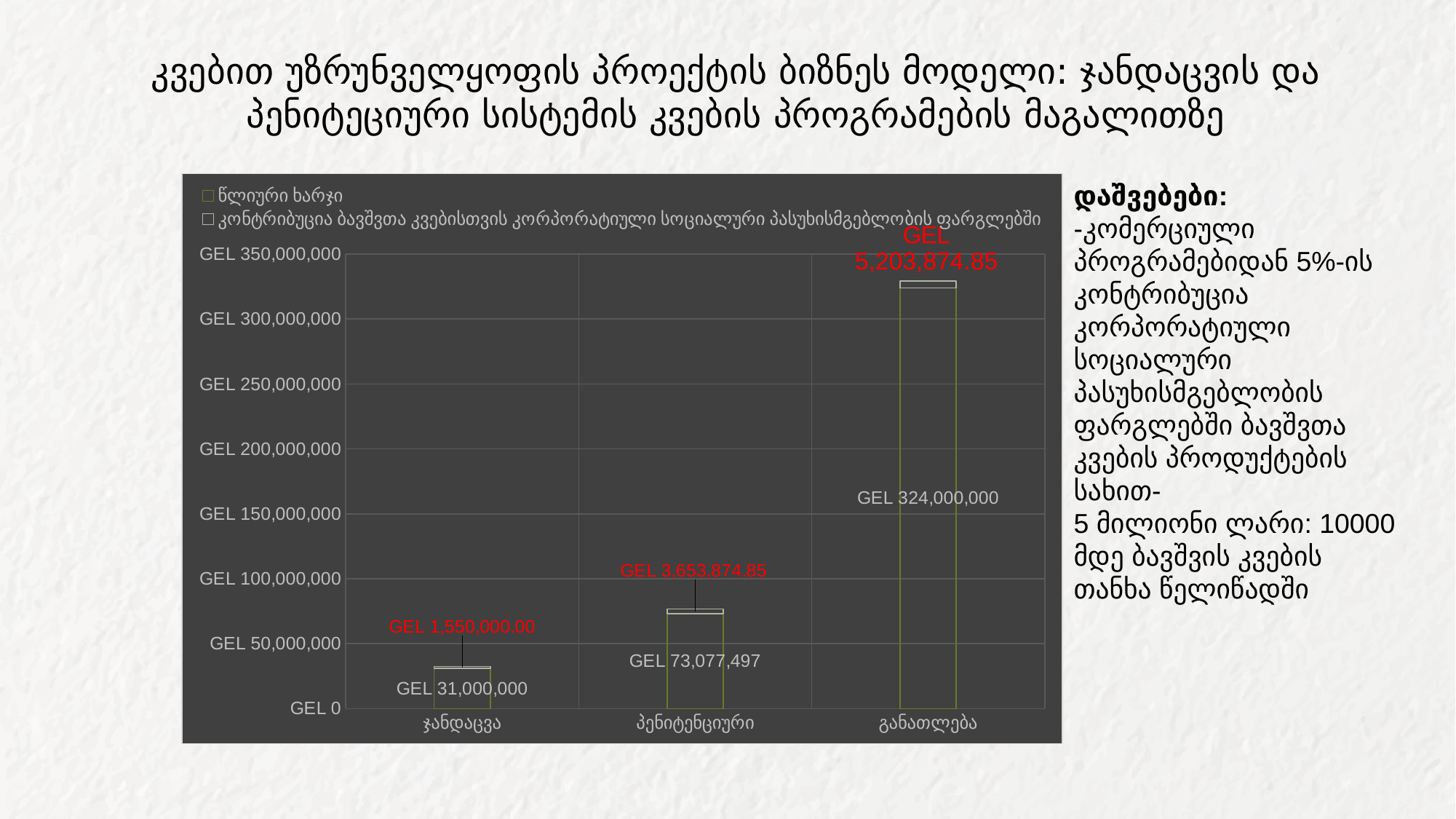
Which category has the highest წლიური ხარჯი value? განათლება What is the წლიური ხარჯი value for განათლება? GEL 324,000,000 What is the წლიური ხარჯი value for ჯანდაცვა? GEL 31,000,000 What is the წლიური ხარჯი value for პენიტენციური? GEL 73,077,497 Which category has the lowest წლიური ხარჯი value? ჯანდაცვა What type of chart is shown on the slide? bar chart What is the total of the stacked bar for ჯანდაცვა? GEL 32,550,000.00 How many series does the chart legend list? 2 How many categories are shown on the x axis of the chart? 3 What is the difference between the წლიური ხარჯი values for განათლება and ჯანდაცვა? GEL 293,000,000 What is the contribution (კონტრიბუცია) value shown in red for განათლება? GEL 5,203,874.85 What is the contribution (კონტრიბუცია) value shown in red for პენიტენციური? GEL 3,653,874.85